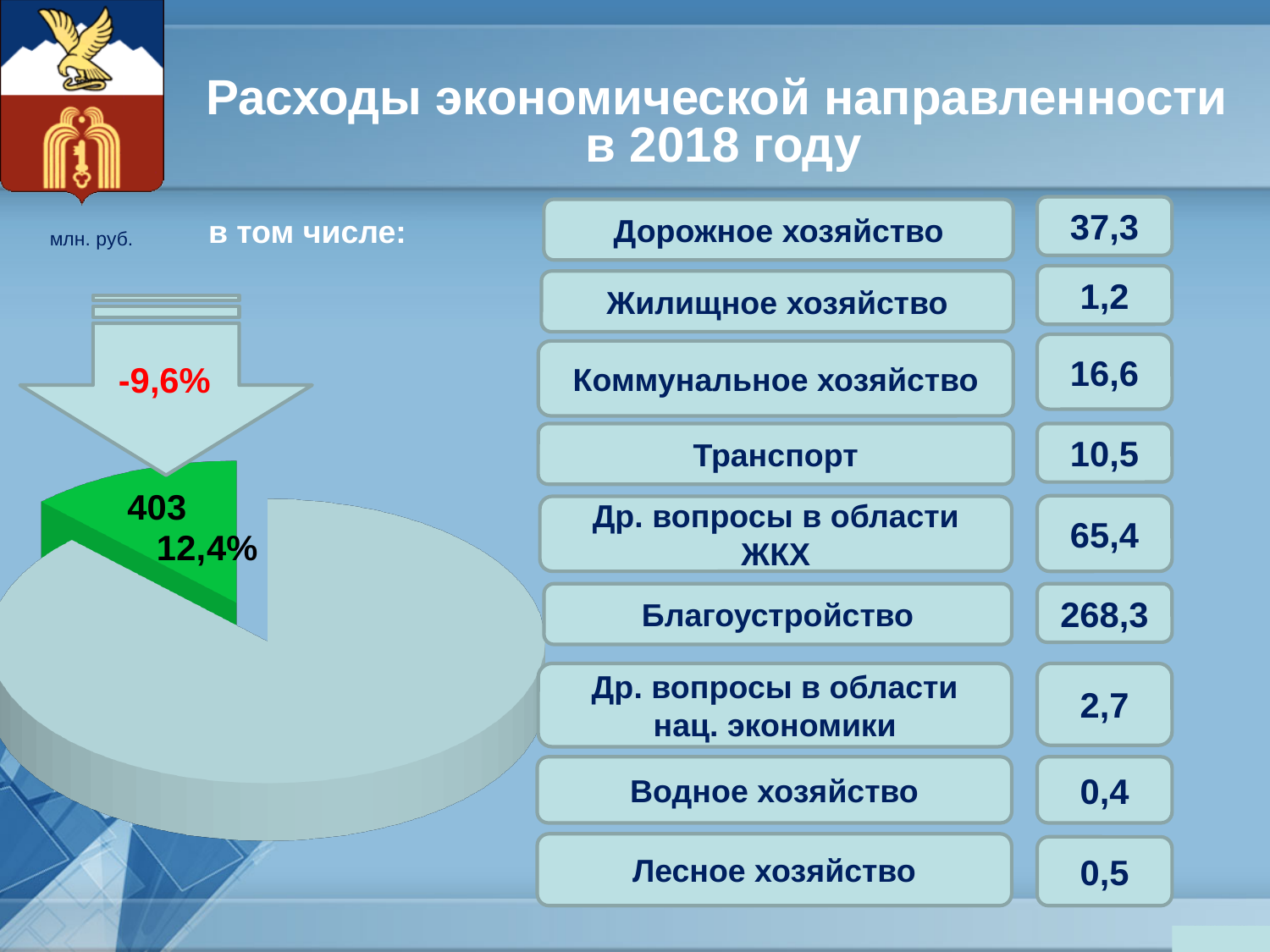
What percentage change is shown on the arrow above the pie chart? -9,6% What kind of chart is shown on the slide? pie chart What value is printed on the green slice of the pie chart? 403 In the breakdown list next to the pie chart, what is the value for Благоустройство? 268,3 What share of the pie does the green slice represent? 12,4% In the breakdown list next to the pie chart, which item has the highest value? Благоустройство In the breakdown list next to the pie chart, what is the difference between Дорожное хозяйство and Коммунальное хозяйство? 20,7 In the breakdown list next to the pie chart, which item has the lowest value? Водное хозяйство Is the green slice larger or smaller than the remaining part of the pie? smaller What colour is the highlighted (exploded) slice of the pie chart? green How many slices does the pie chart have? 2 What unit is indicated for the values on the slide? млн. руб.